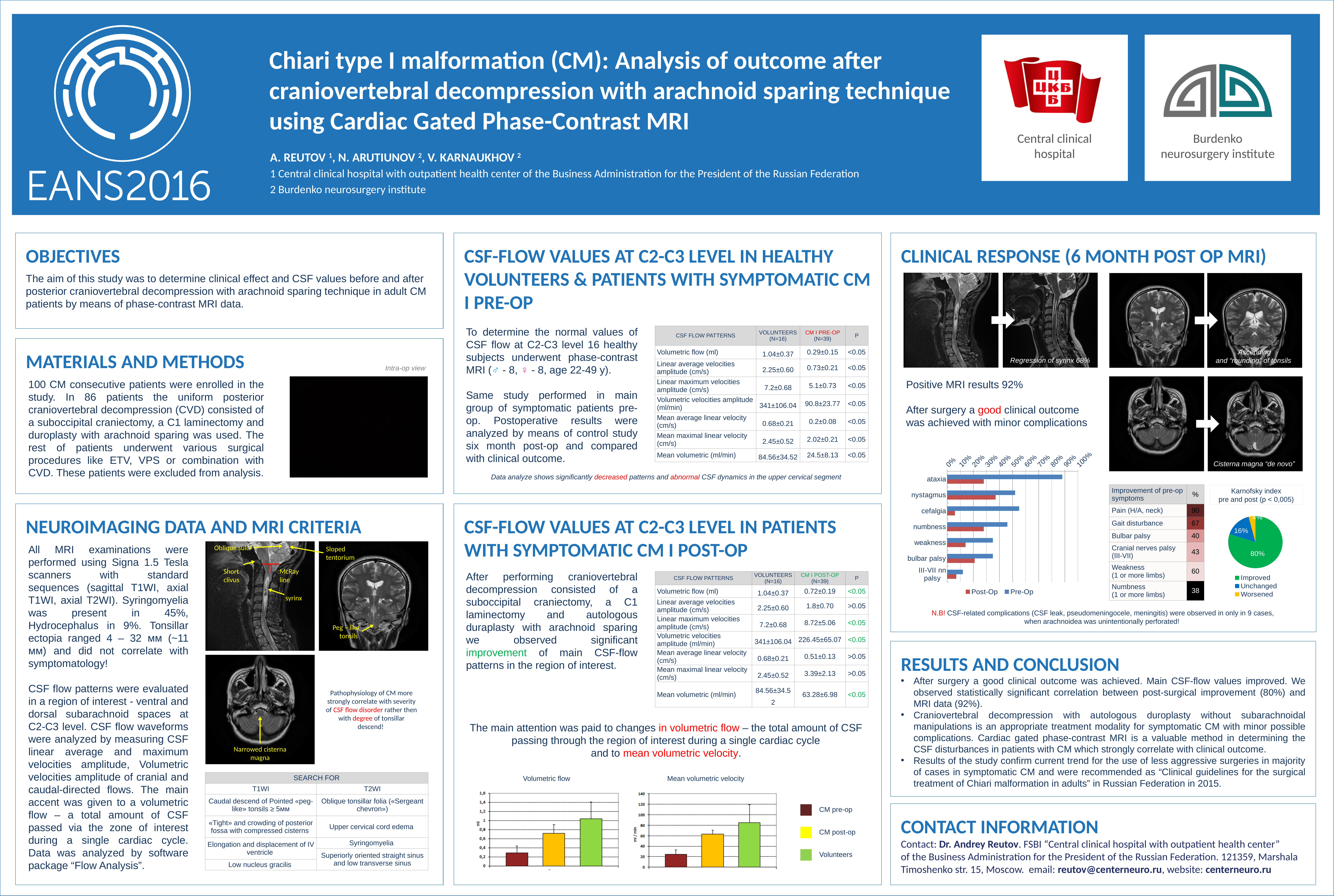
In the 'Volumetric flow' chart at the bottom, which group has the highest bar? Volunteers In the 'Volumetric flow' chart at the bottom, is the value for CM pre-op greater or less than 0.4? less In the pie chart under 'Clinical response', what share of patients were Unchanged? 16% In the 'Mean volumetric velocity' chart at the bottom, which group has the lowest bar? CM pre-op In the Pre-Op/Post-Op symptom chart, which symptom has the highest Pre-Op value? ataxia In the pie chart under 'Clinical response', what share of patients were Improved? 80% In the Pre-Op/Post-Op symptom chart, which is larger for ataxia, the Pre-Op or the Post-Op value? Pre-Op In the Pre-Op/Post-Op symptom chart, is the Pre-Op value for ataxia greater or less than 70%? greater What type of chart is the Pre-Op/Post-Op symptom chart under 'Clinical response'? bar chart How many series does the legend of the Pre-Op/Post-Op symptom chart list? 2 How many symptom categories are shown in the Pre-Op/Post-Op symptom chart? 7 In the pie chart under 'Clinical response', which category has the largest slice? Improved